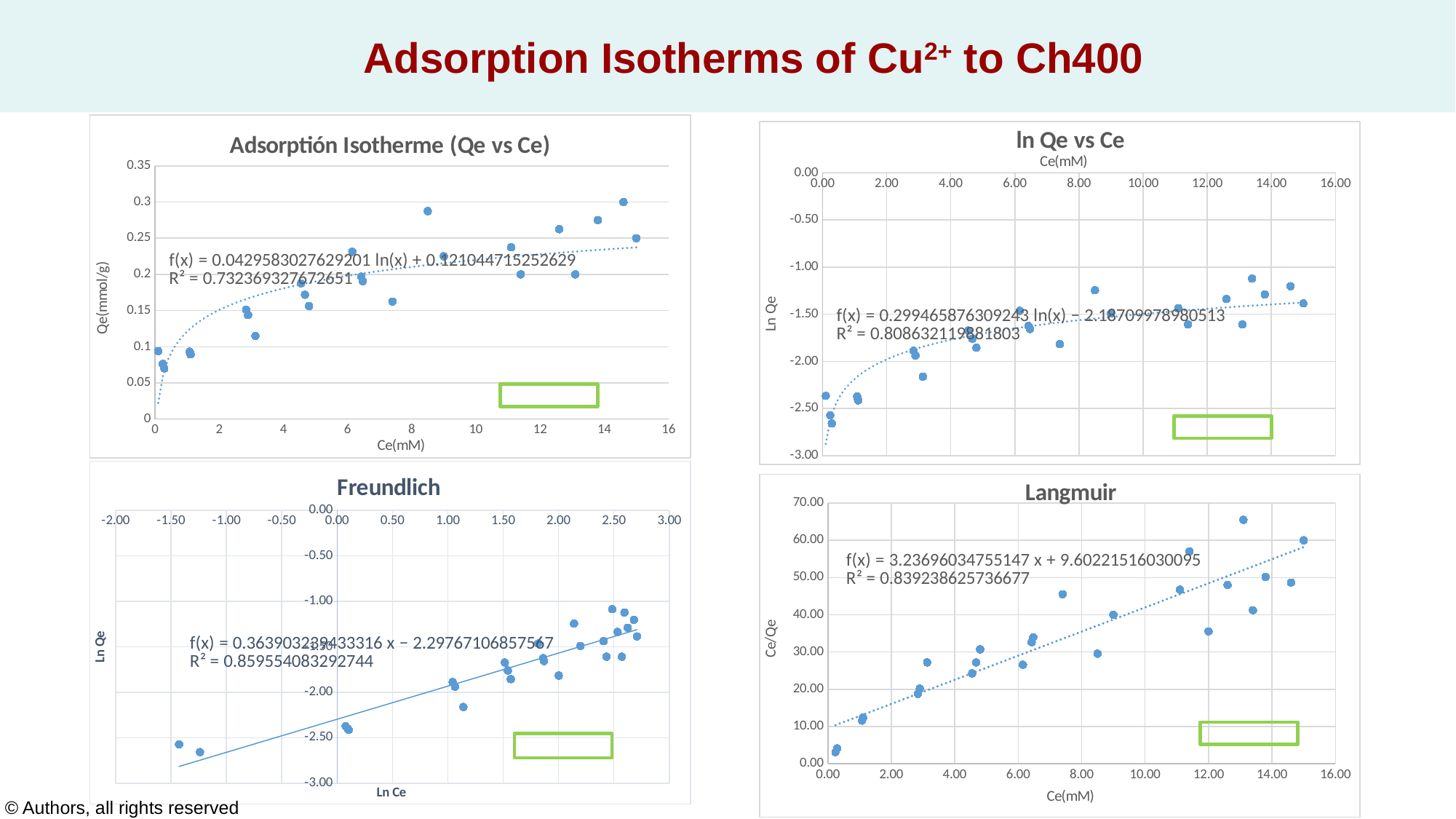
In the 'Langmuir' chart, do the Ce/Qe values generally rise or fall as Ce increases? rise In the 'ln Qe vs Ce' chart, what R² value is printed for the trendline? R² = 0.808632119881803 In the 'Adsorption Isotherme (Qe vs Ce)' chart, is the Qe value of the point near Ce = 8.5 greater or less than 0.25? greater In the 'Freundlich' chart, what R² value is printed for the trendline? R² = 0.859554083292744 In the 'Adsorption Isotherme (Qe vs Ce)' chart, what R² value is printed for the trendline? R² = 0.732369327672651 What kind of chart is the 'Langmuir' chart? scatter chart In the 'Langmuir' chart, what R² value is printed for the trendline? R² = 0.839238625736677 How many charts are shown on the slide? 4 In the 'Langmuir' chart, is the highest plotted Ce/Qe value greater or less than 60.00? greater In the 'Freundlich' chart, do the Ln Qe values generally rise or fall as Ln Ce increases? rise What is the x-axis label of the 'Adsorption Isotherme (Qe vs Ce)' chart? Ce(mM) What is the y-axis label of the 'Langmuir' chart? Ce/Qe